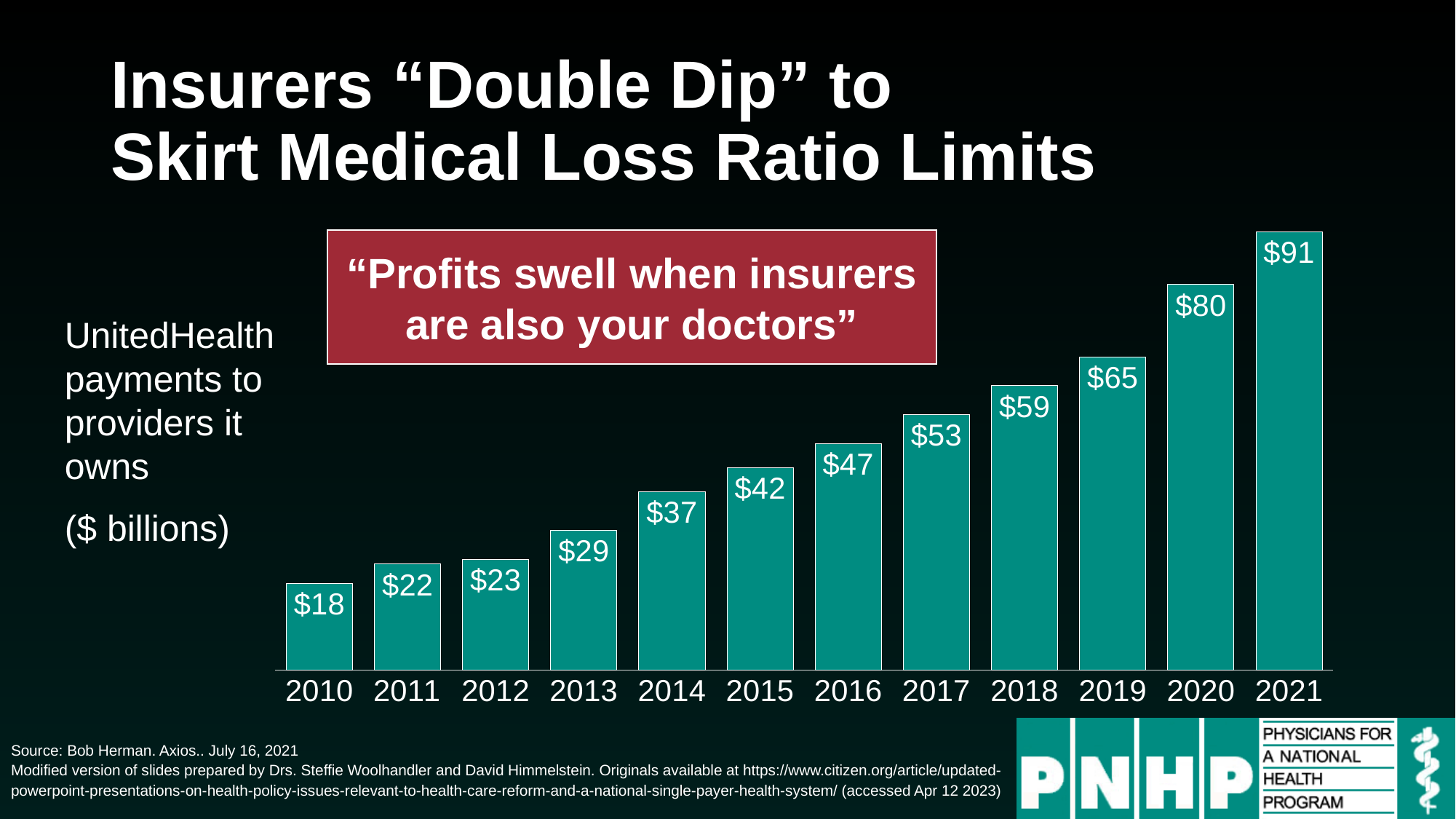
What unit are the chart values expressed in? $ billions What is the difference between the values for 2021 and 2020? $11 Do the values rise or fall from 2010 to 2021? Rise What is the value for 2015? $42 What is the value for 2010? $18 Which year has the lowest value? 2010 What kind of chart is shown on the slide? Bar chart What is the value for 2019? $65 Which year has the highest value? 2021 How many years are shown on the x axis? 12 Which is larger, the value for 2014 or the value for 2016? 2016 What is the difference between the values for 2017 and 2013? $24